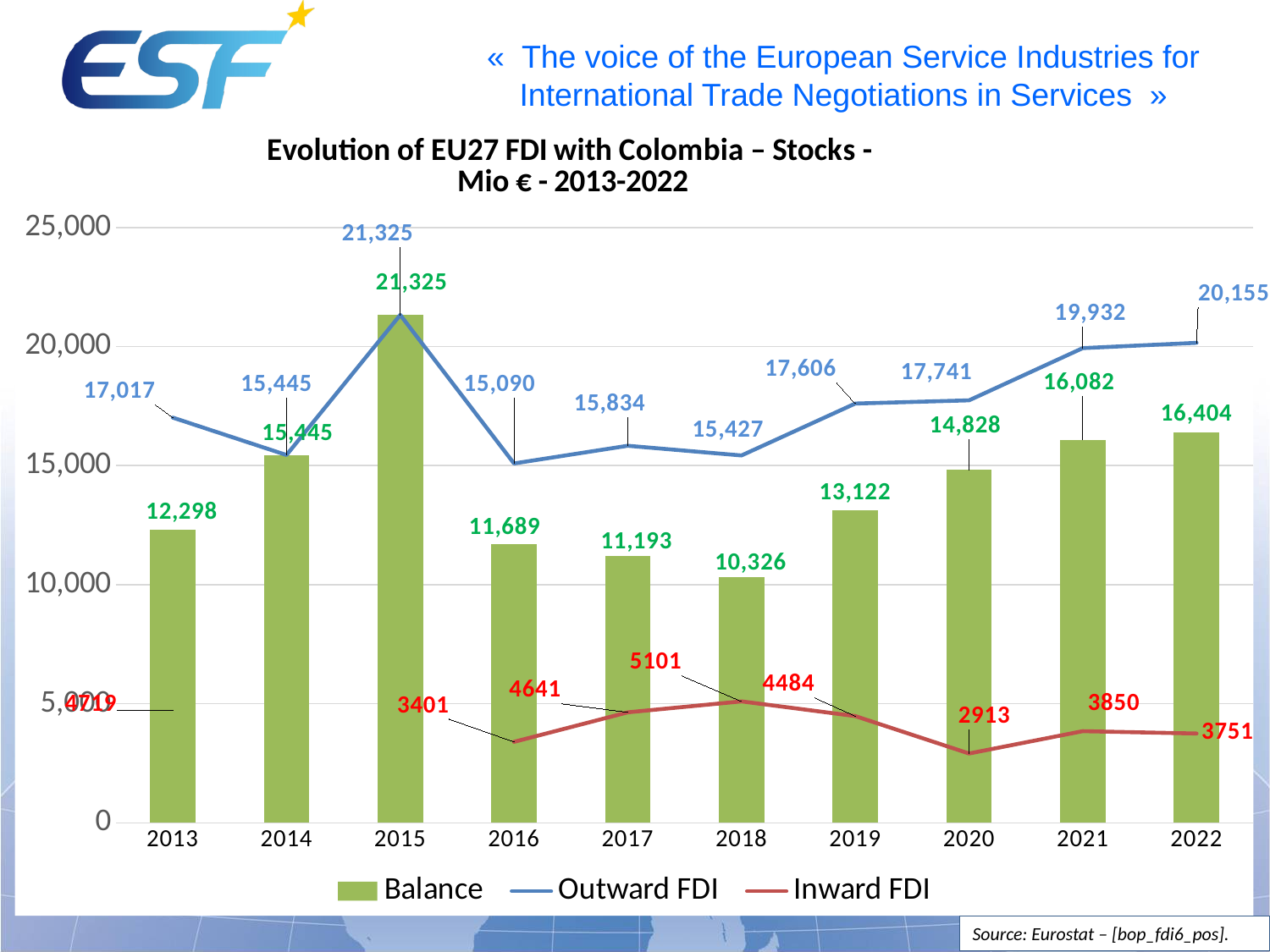
What kind of chart is this? Combined bar and line chart What is the title of the chart? Evolution of EU27 FDI with Colombia – Stocks - Mio € - 2013-2022 How many years are shown on the x axis? 10 Does the Outward FDI line rise or fall from 2019 to 2022? Rise What is the Balance value for 2015? 21,325 What is the Outward FDI value for 2022? 20,155 What is the Inward FDI value for 2020? 2913 In which year is the Balance lowest? 2018 Which year has the larger Balance, 2021 or 2022? 2022 What is the difference between the Outward FDI values for 2022 and 2021? 223 How many series does the legend list? 3 In which year is the Balance highest? 2015